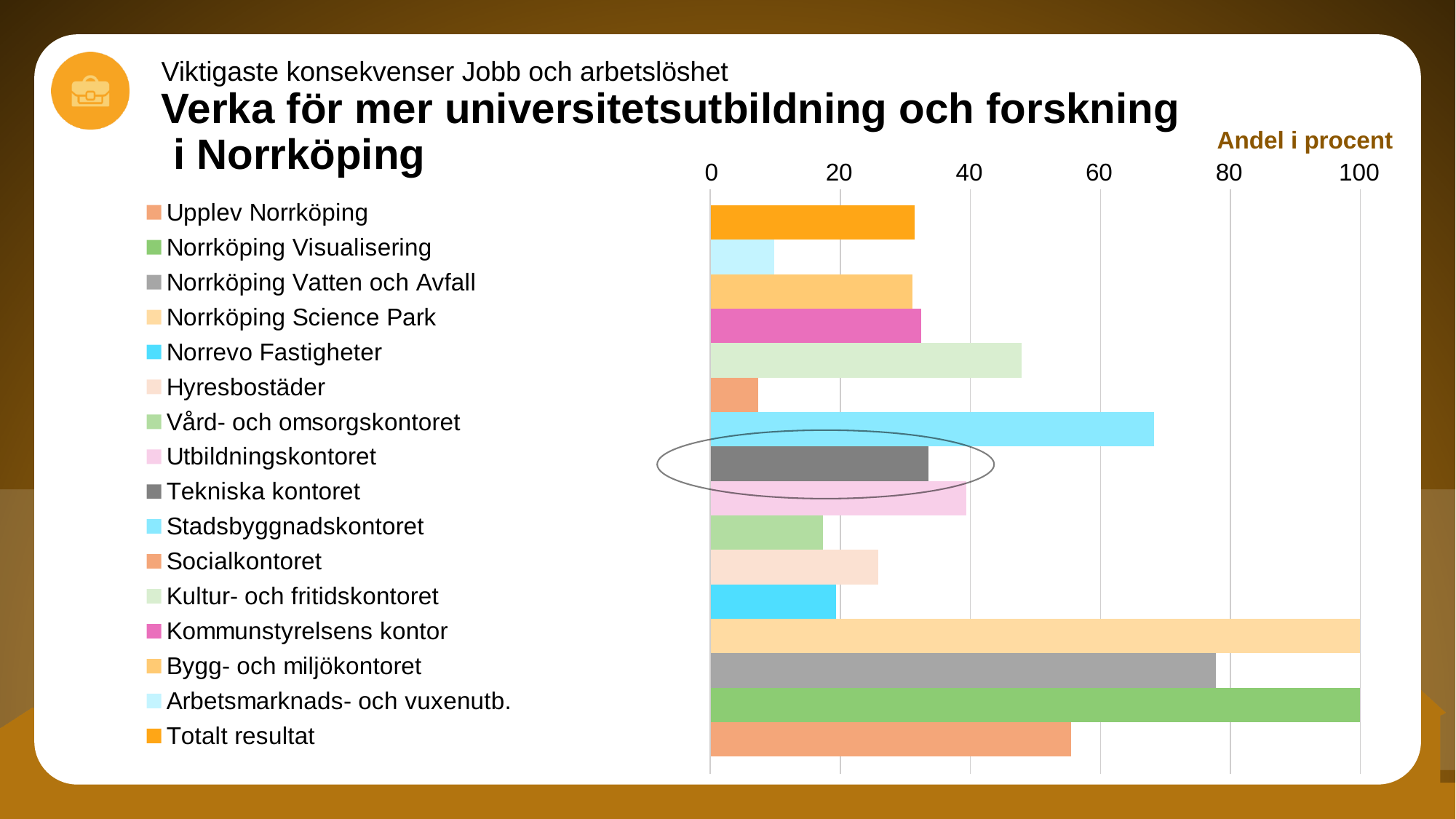
Is the value for Norrköping Vatten och Avfall greater or less than 60? greater How many series does the legend list? 16 What is the label shown above the horizontal axis of the chart? Andel i procent Is the value for Totalt resultat greater or less than 40? less Which is larger, the value for Upplev Norrköping or the value for Kultur- och fritidskontoret? Upplev Norrköping What is the value for Norrköping Science Park? 100 Is the value for Arbetsmarknads- och vuxenutb. greater or less than 20? less What is the value for Norrköping Visualisering? 100 Which is larger, the value for Tekniska kontoret or the value for Vård- och omsorgskontoret? Tekniska kontoret Which series has the lowest value? Socialkontoret What kind of chart is shown on the slide? bar chart